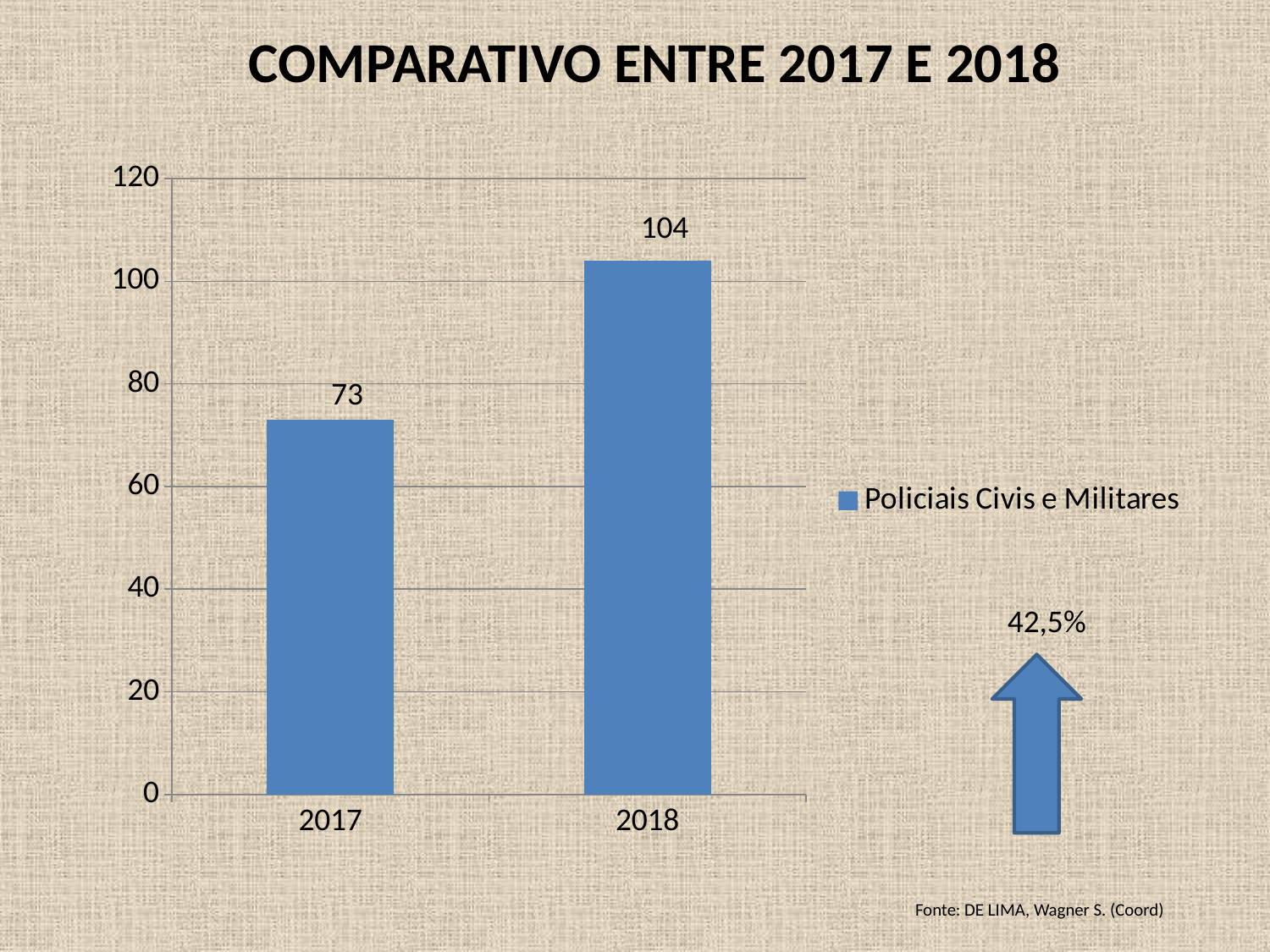
What is the difference between the values for 2018 and 2017? 31 How many categories are shown on the x axis? 2 How many series does the legend list? 1 What kind of chart is shown on the slide? bar chart Which is larger, the value for 2017 or the value for 2018? 2018 What is the value for 2018? 104 Is the value for 2018 greater or less than 100? greater What is the value for 2017? 73 Which year has the lowest value? 2017 What is the name of the series in the legend? Policiais Civis e Militares Is the value for 2017 greater or less than 80? less Which year has the highest value? 2018